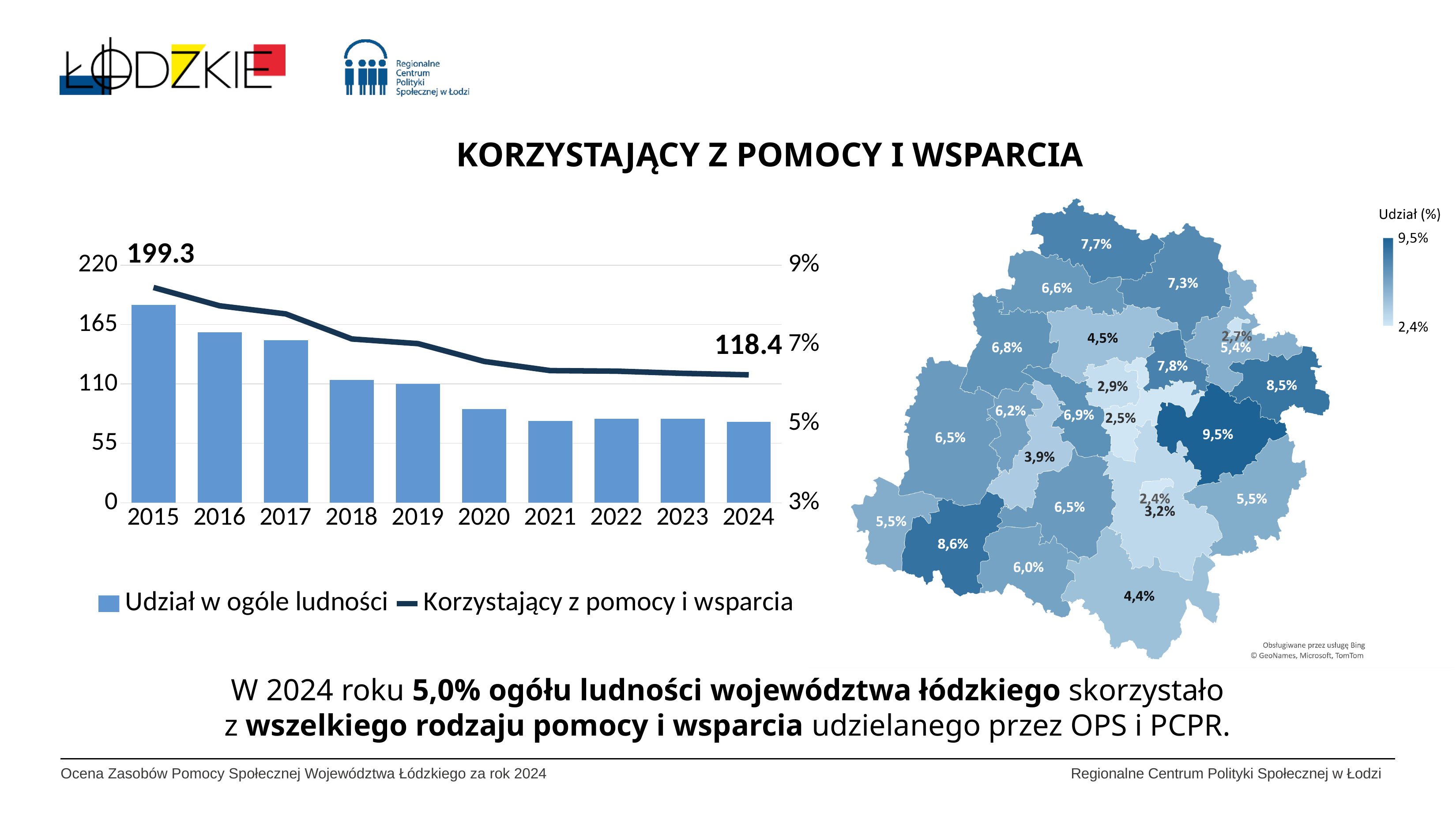
In the left chart, what value is labelled on the 'Korzystający z pomocy i wsparcia' line for 2015? 199.3 In the left chart, is the bar for 2020 greater or less than 110 on the left axis? less In the left chart, which year has the tallest bar? 2015 In the left chart, which bar is taller, 2015 or 2020? 2015 What kind of chart is shown on the left of the slide? A bar chart combined with a line chart In the left chart, do the values rise or fall from 2015 to 2024? Fall In the left chart, how many years are shown on the x axis? 10 In the left chart, what value is labelled on the 'Korzystający z pomocy i wsparcia' line for 2024? 118.4 On the map on the right, what is the lowest percentage shown for any area? 2,4% On the map on the right, what is the highest percentage shown for any area? 9,5% In the left chart, how many series does the legend list? 2 In the left chart, what is the difference between the labelled line values for 2015 and 2024? 80.9